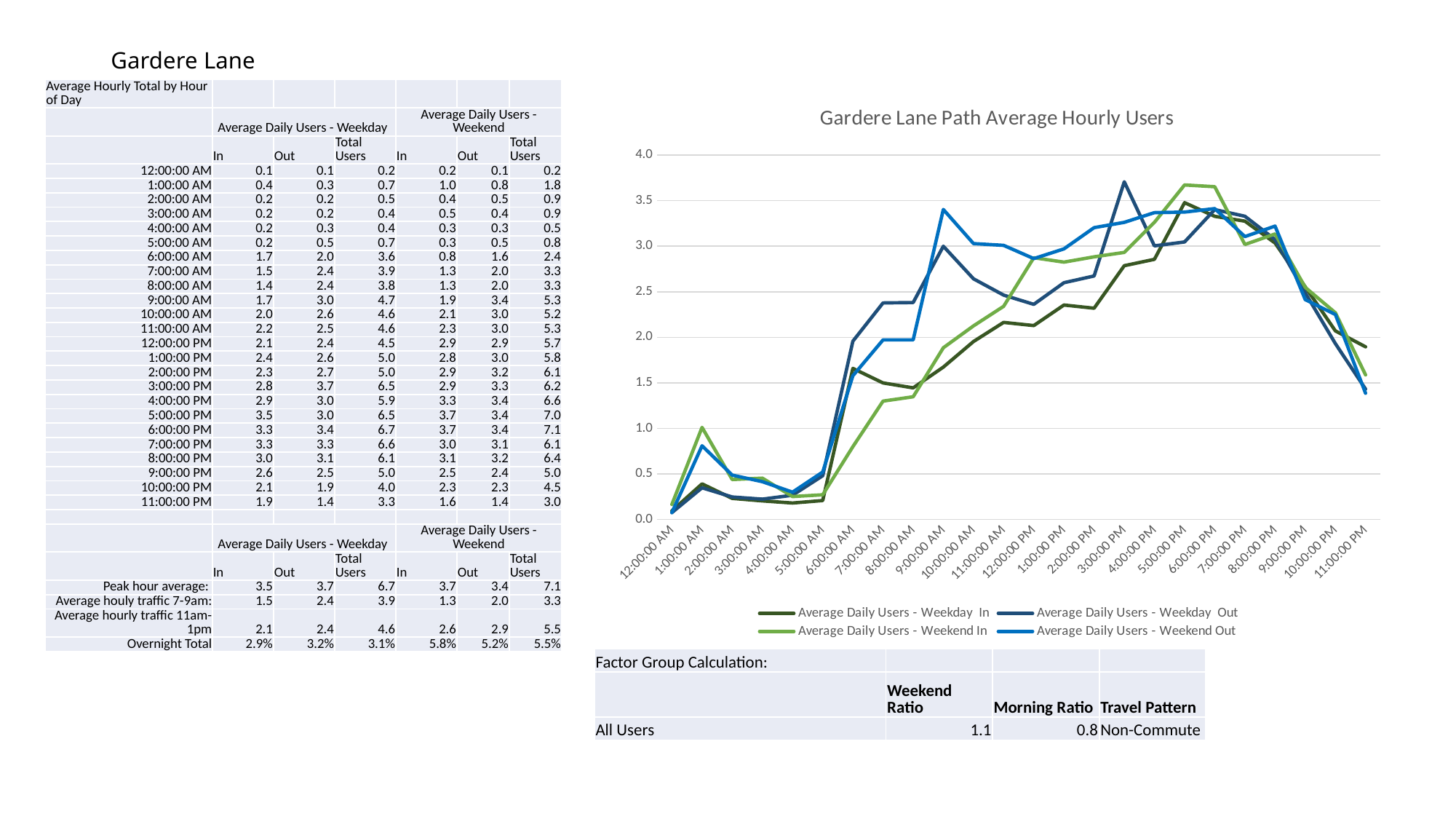
In the 'Gardere Lane Path Average Hourly Users' chart, is the value for Average Daily Users - Weekend In at 7:00:00 AM greater or less than 1.5? less How many series does the legend of the 'Gardere Lane Path Average Hourly Users' chart list? 4 In the 'Gardere Lane Path Average Hourly Users' chart, which is larger at 7:00:00 AM: Average Daily Users - Weekday In or Average Daily Users - Weekday Out? Average Daily Users - Weekday Out In the 'Gardere Lane Path Average Hourly Users' chart, is the value for Average Daily Users - Weekday In at 12:00:00 AM greater or less than 0.5? less In the 'Gardere Lane Path Average Hourly Users' chart, is the value for Average Daily Users - Weekday In at 2:00:00 PM greater or less than 2.5? less In the 'Gardere Lane Path Average Hourly Users' chart, which is larger at 9:00:00 AM: Average Daily Users - Weekend Out or Average Daily Users - Weekday In? Average Daily Users - Weekend Out In the 'Gardere Lane Path Average Hourly Users' chart, does the Average Daily Users - Weekday Out line rise or fall from 6:00:00 PM to 11:00:00 PM? fall What kind of chart is 'Gardere Lane Path Average Hourly Users'? line chart What is the title of the line chart on the slide? Gardere Lane Path Average Hourly Users How many hourly points are plotted along the x axis of the 'Gardere Lane Path Average Hourly Users' chart? 24